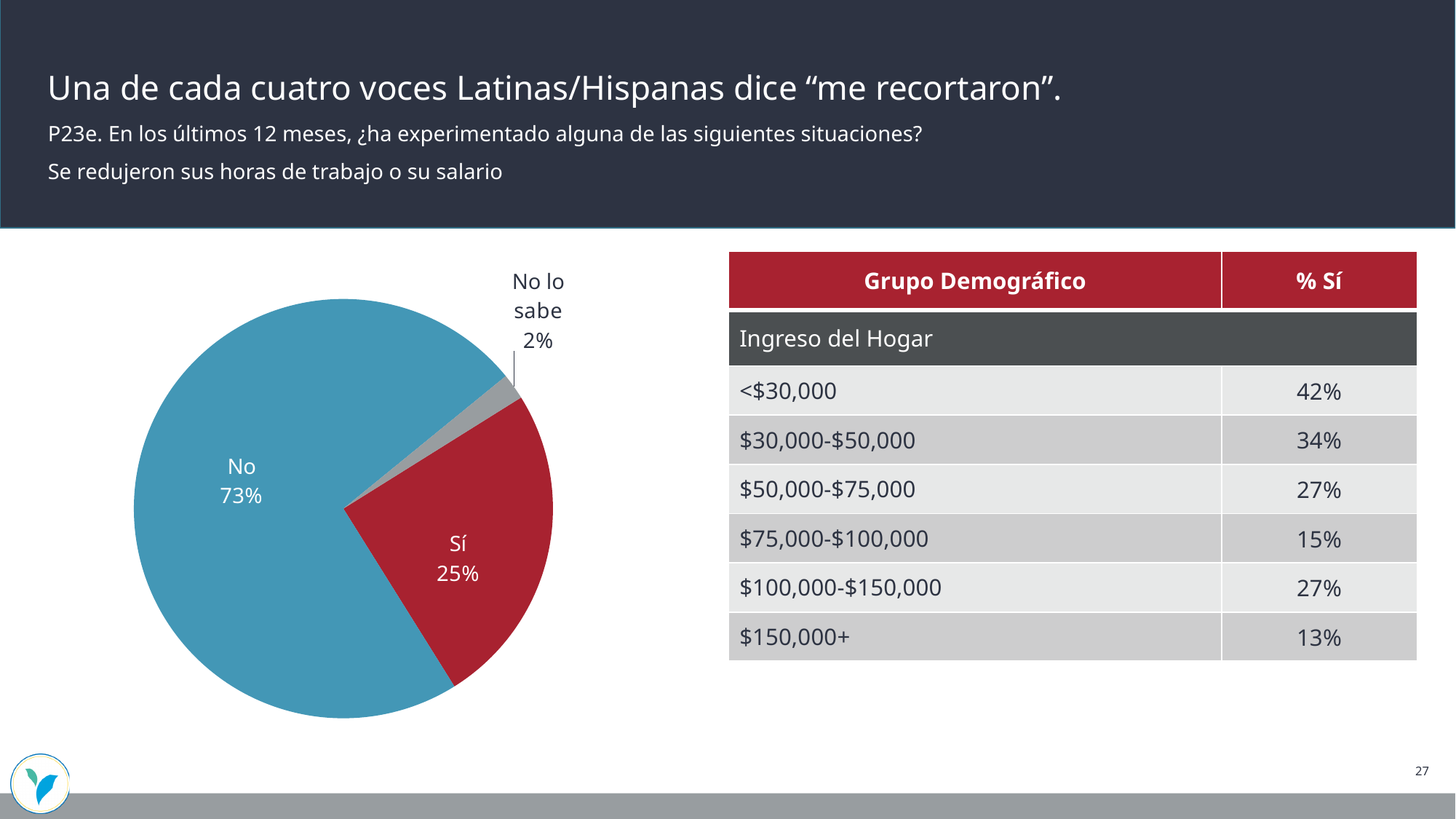
Which slice of the pie chart is the smallest? No lo sabe What share of the pie chart is labelled "Sí"? 25% What share of the pie chart is labelled "No"? 73% What kind of chart is shown on the slide? Pie chart How many slices does the pie chart have? 3 What share of the pie chart is labelled "No lo sabe"? 2% What colour is the "No" slice of the pie chart? Blue Which is larger in the pie chart, the "Sí" slice or the "No lo sabe" slice? Sí Which slice of the pie chart is the largest? No What is the difference in percentage points between the "No" slice and the "Sí" slice? 48 What colour is the "Sí" slice of the pie chart? Red